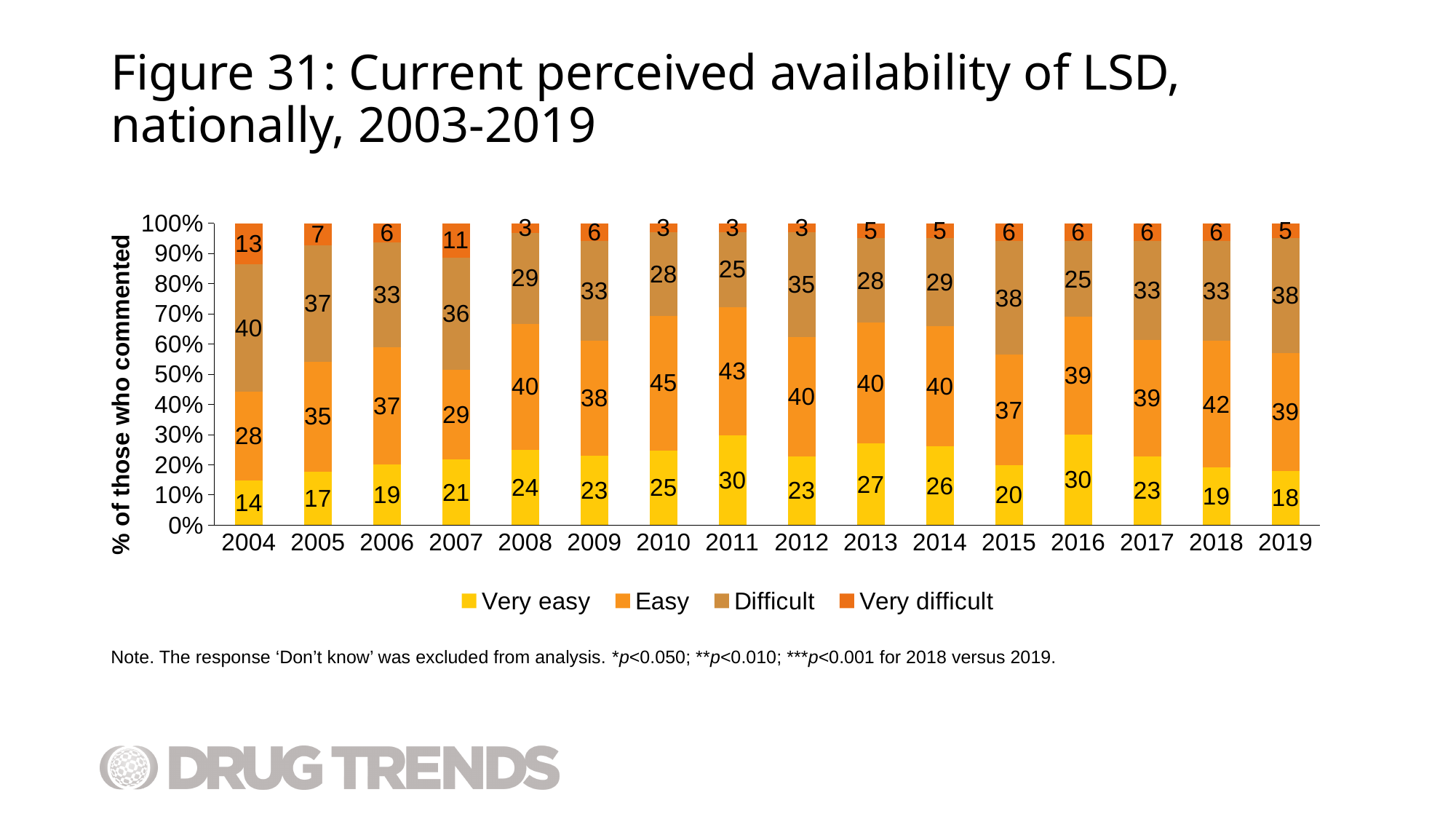
In which year is the 'Very easy' value lowest? 2004 What is the total of the stacked bar for 2019? 100 In 2018, which is larger: the 'Easy' value or the 'Difficult' value? Easy What is the 'Difficult' value for 2019? 38 How many years are shown on the x axis? 16 In which year is the 'Difficult' value highest? 2004 In which year is the 'Easy' value highest? 2010 What is the 'Very difficult' value for 2004? 13 What percentage of respondents rated LSD as 'Very easy' to obtain in 2011? 30 What kind of chart is shown? Stacked bar chart What is the difference between the 'Easy' value in 2010 and in 2004? 17 How many series does the legend list? 4